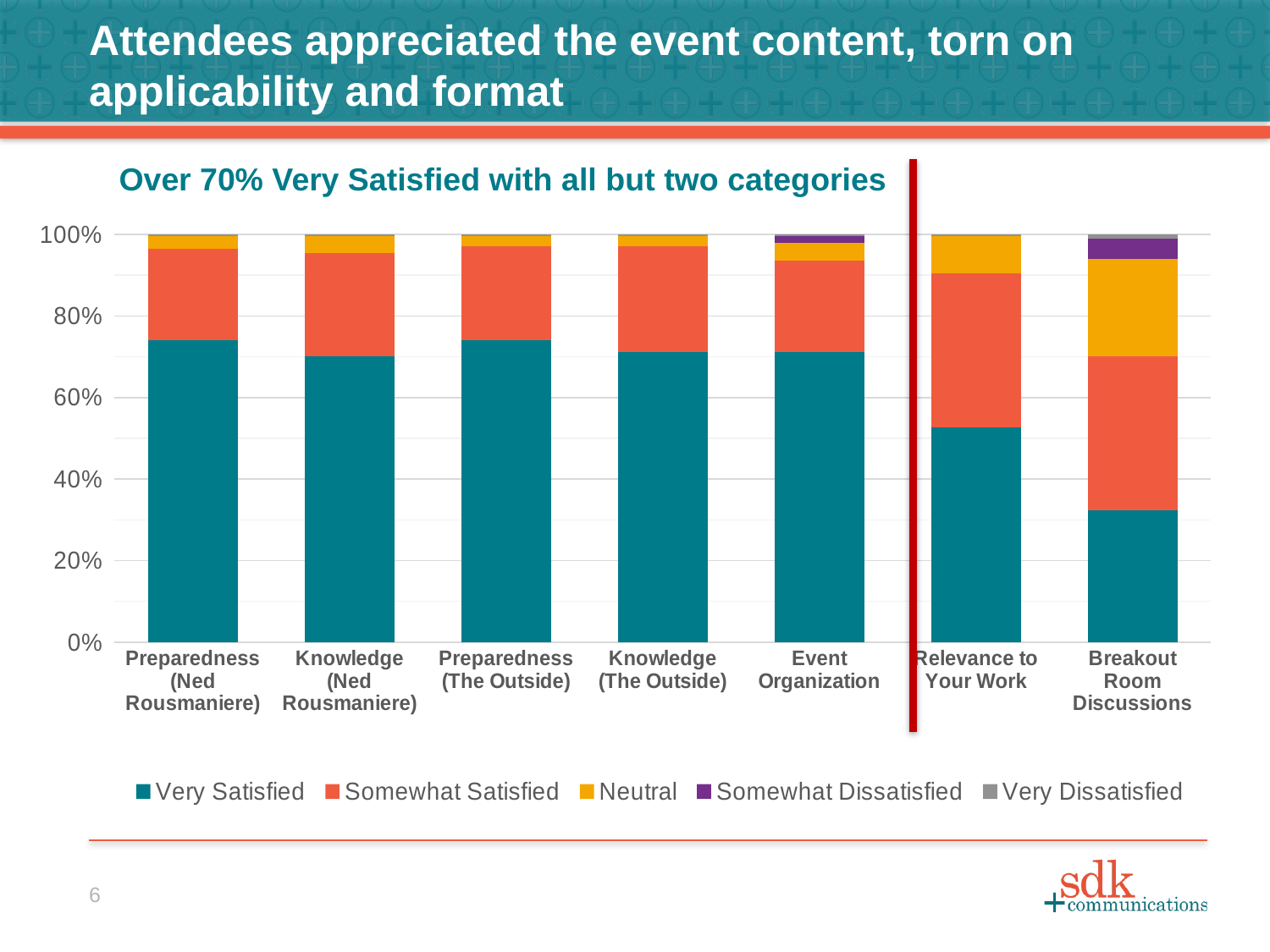
Is the Very Satisfied share for Relevance to Your Work greater or less than 60%? less How many categories are shown along the x axis of the chart? 7 Which category has the largest Neutral share? Breakout Room Discussions Which has the larger Very Satisfied share, Relevance to Your Work or Breakout Room Discussions? Relevance to Your Work Is the Very Satisfied share for Breakout Room Discussions greater or less than 40%? less What is the total of the stacked bar for Event Organization? 100% What is the title of the chart? Over 70% Very Satisfied with all but two categories How many series does the chart's legend list? 5 Is the Very Satisfied share for Event Organization greater or less than 60%? greater What kind of chart is shown on the slide? Stacked bar chart Which category has the lowest Very Satisfied share? Breakout Room Discussions